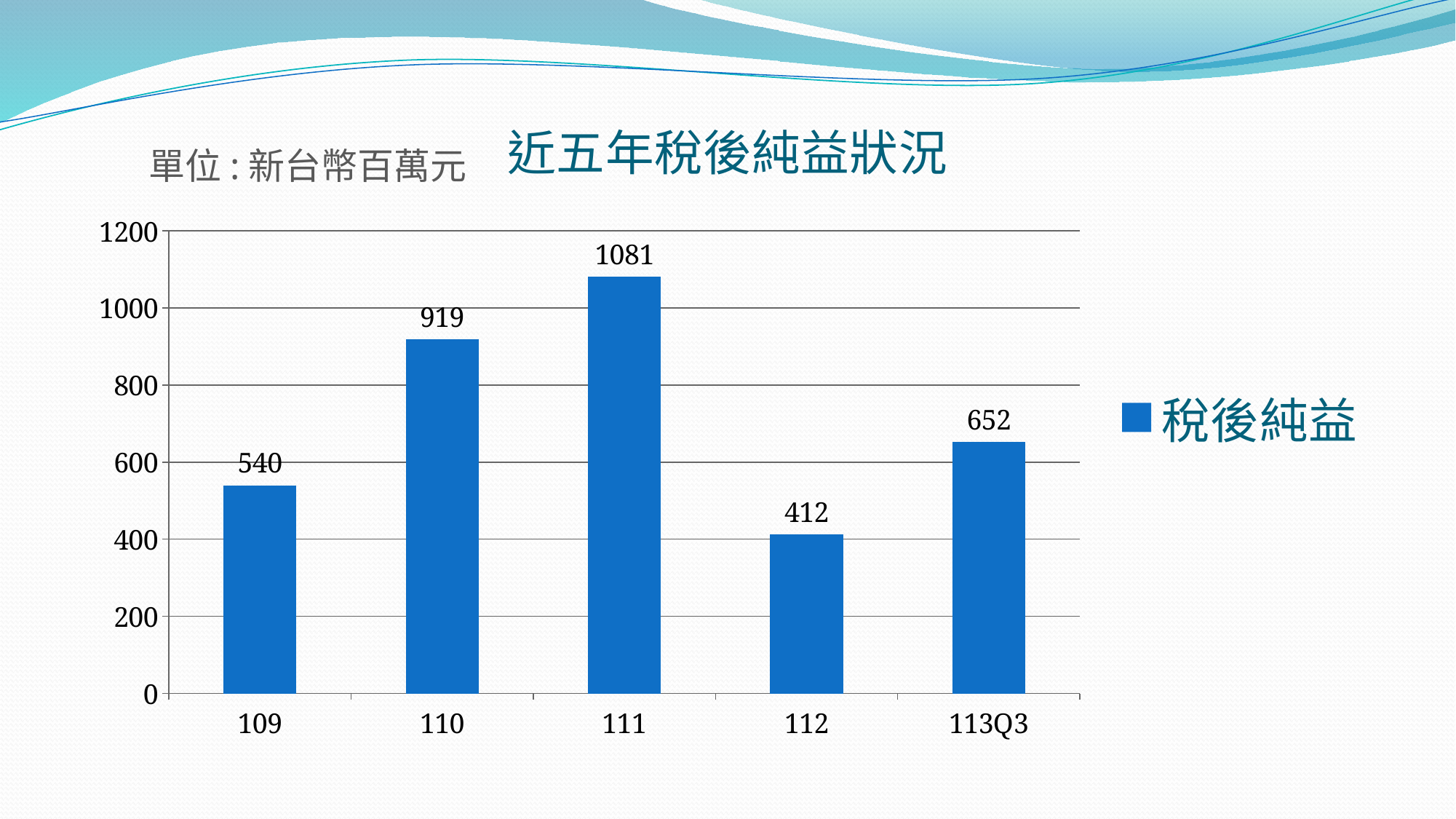
How many categories are shown on the x axis? 5 What is the difference between the 稅後純益 for 113Q3 and 112? 240 What is the value of 稅後純益 for 113Q3? 652 Which year has the highest 稅後純益? 111 What is the difference between the 稅後純益 for 111 and 110? 162 What kind of chart is shown on the slide? Bar chart How many series does the legend list? 1 Which year has the lowest 稅後純益? 112 What is the value of 稅後純益 for 111? 1081 Which is larger, the 稅後純益 for 109 or for 113Q3? 113Q3 What is the title of the chart? 近五年稅後純益狀況 What is the value of 稅後純益 for 109? 540